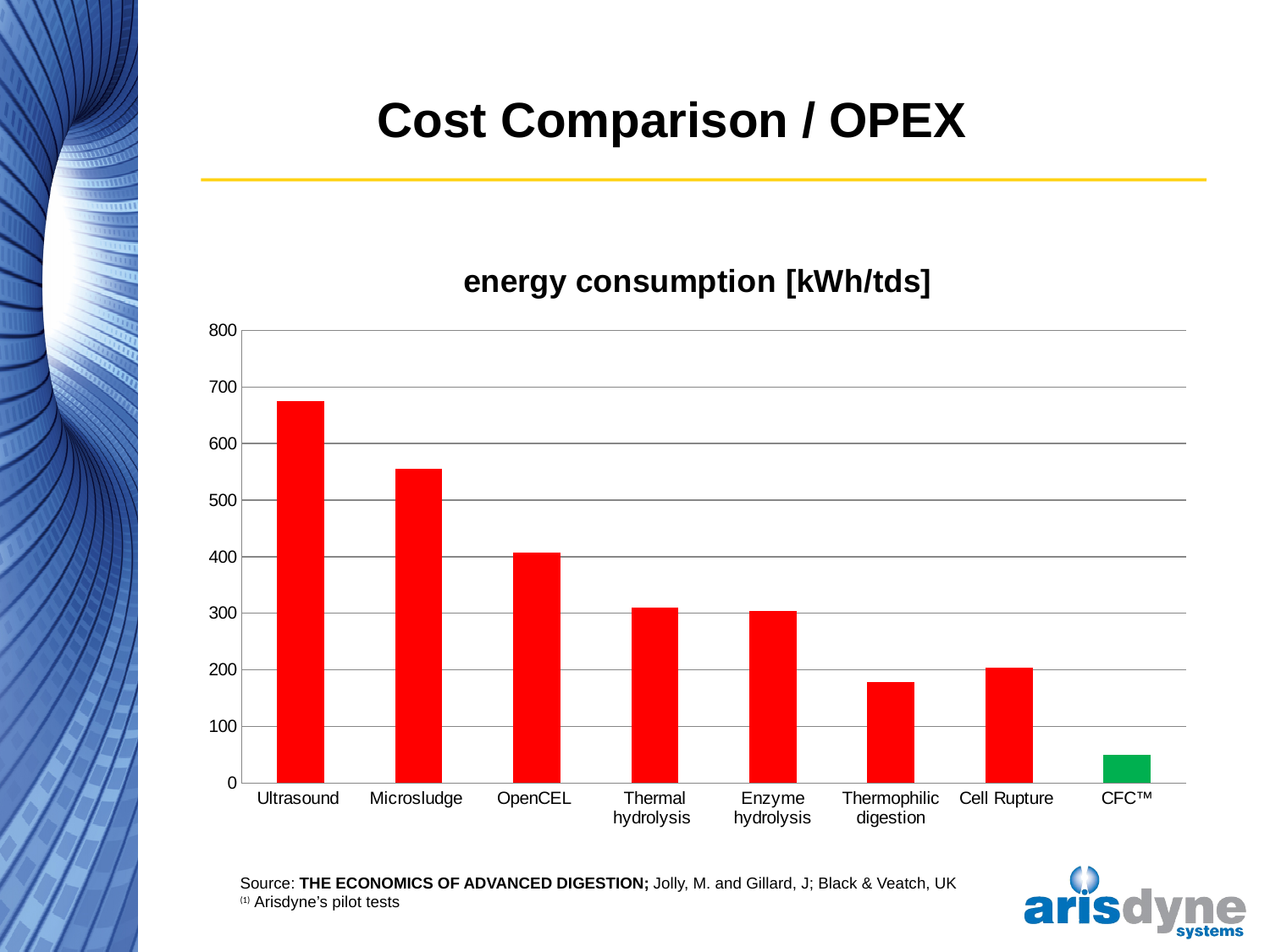
Which is larger, the value for Cell Rupture or the value for Thermophilic digestion? Cell Rupture Is the value for Microsludge greater or less than 500? greater What kind of chart is shown on the slide? bar chart Is the value for CFC™ greater or less than 100? less Is the value for Thermophilic digestion greater or less than 200? less Which bar is shown in a different colour from the others? CFC™ Which category has the highest energy consumption? Ultrasound How many categories are plotted on the x axis? 8 Which category has the lowest energy consumption? CFC™ What is the title of the chart? energy consumption [kWh/tds]